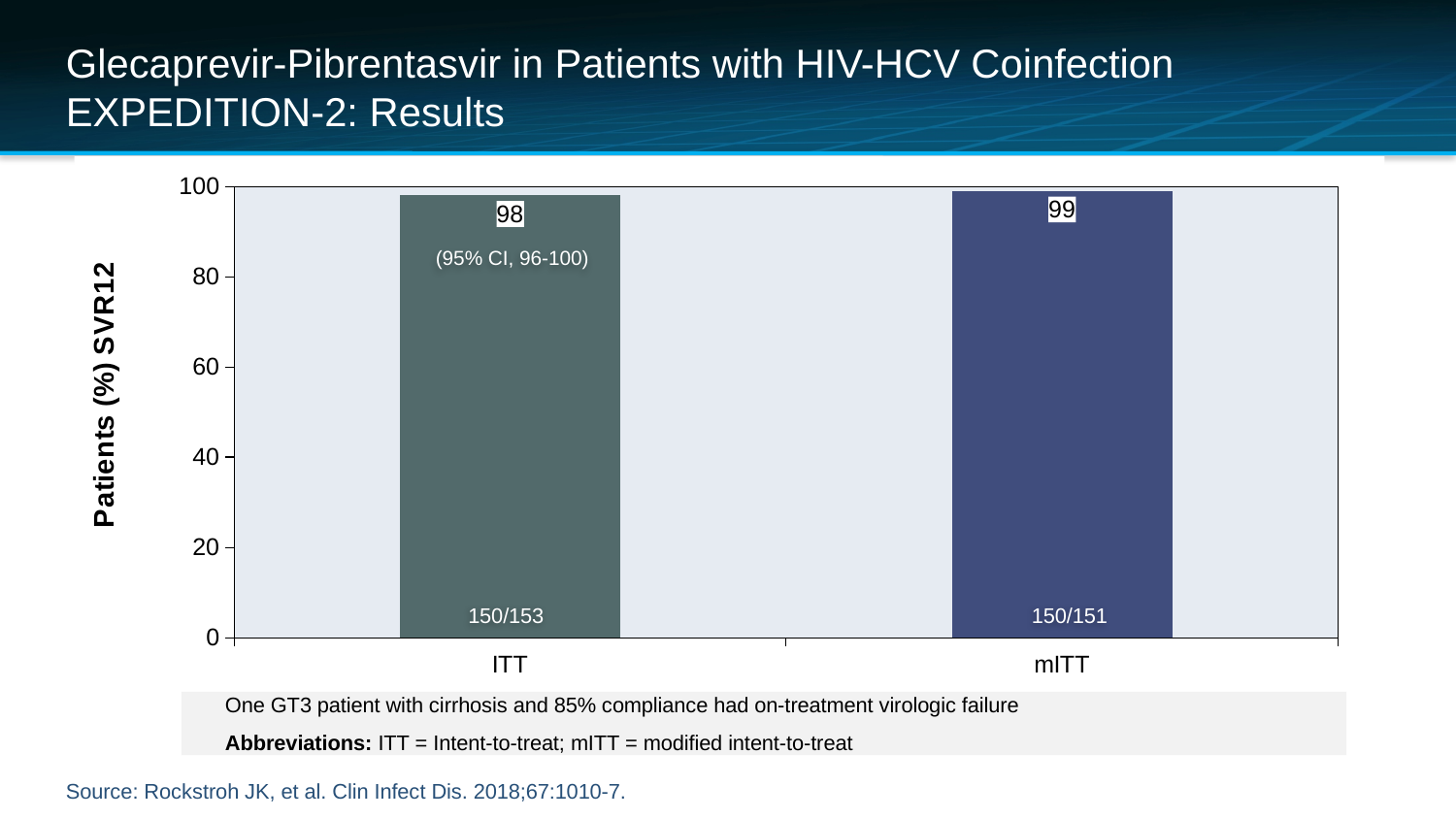
What is the SVR12 rate (%) for the ITT group? 98 What is the 95% confidence interval shown for the ITT group? 96-100 Which group has the higher SVR12 rate, ITT or mITT? mITT How many patients achieved SVR12 out of the total in the mITT group, as labelled on the bar? 150/151 What is the label of the y axis? Patients (%) SVR12 How many categories are shown on the x axis? 2 What is the maximum value shown on the y axis? 100 What kind of chart is shown on the slide? Bar chart What is the SVR12 rate (%) for the mITT group? 99 What is the difference in SVR12 rate between the mITT and ITT groups? 1 Is the value for ITT greater or less than 80? greater How many patients achieved SVR12 out of the total in the ITT group, as labelled on the bar? 150/153